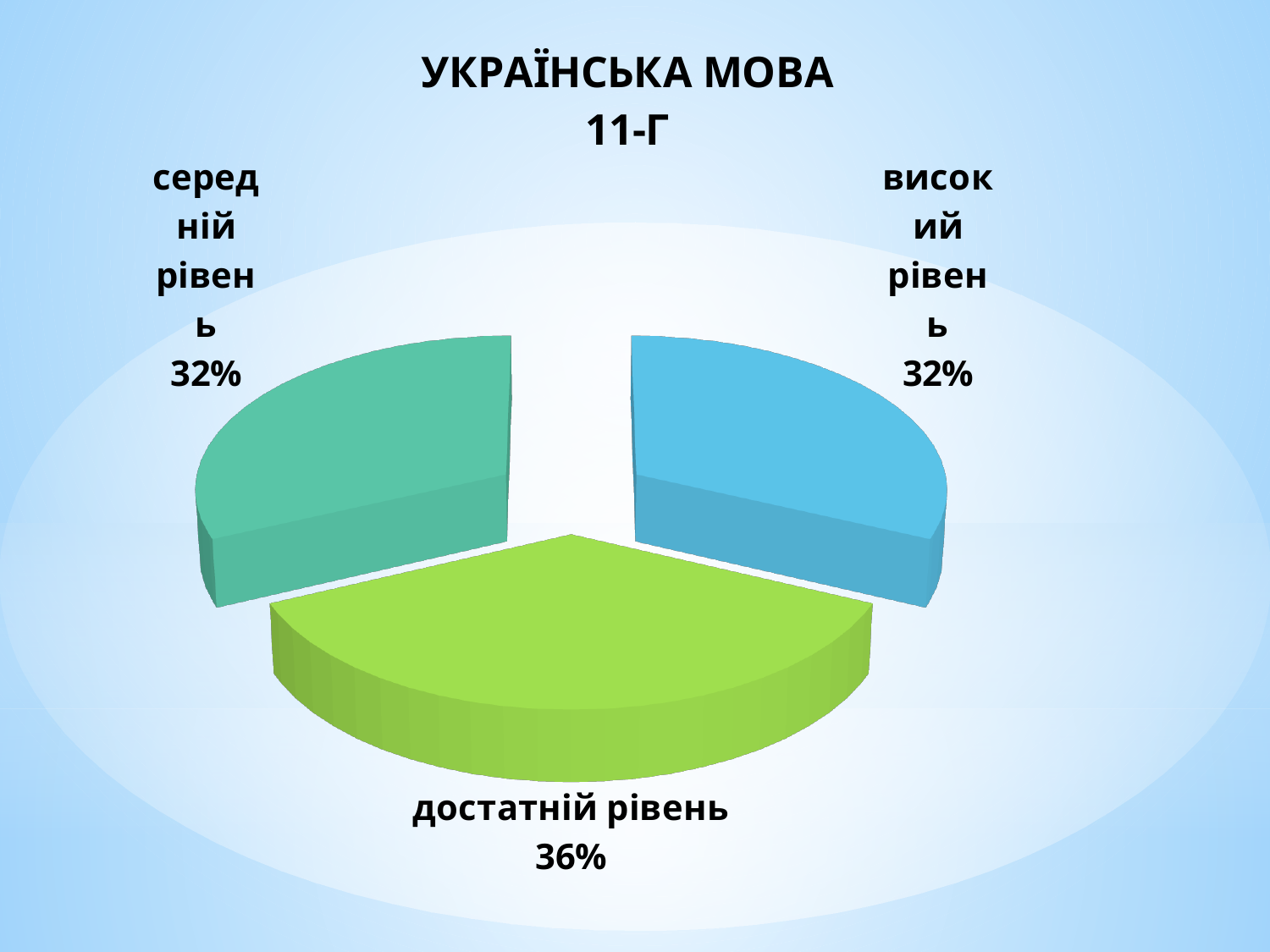
Is the share for достатній рівень greater or less than 35%? greater What is the difference between the share for достатній рівень and the share for середній рівень? 4% What share of the pie is labelled достатній рівень? 36% What colour is the slice for достатній рівень? green What is the value shown for середній рівень? 32% Which is larger, достатній рівень or високий рівень? достатній рівень How many slices does the pie chart have? 3 What is the value shown for високий рівень? 32% What is the title of the chart? УКРАЇНСЬКА МОВА 11-Г What kind of chart is shown on the slide? pie chart Which level has the largest share of the pie? достатній рівень